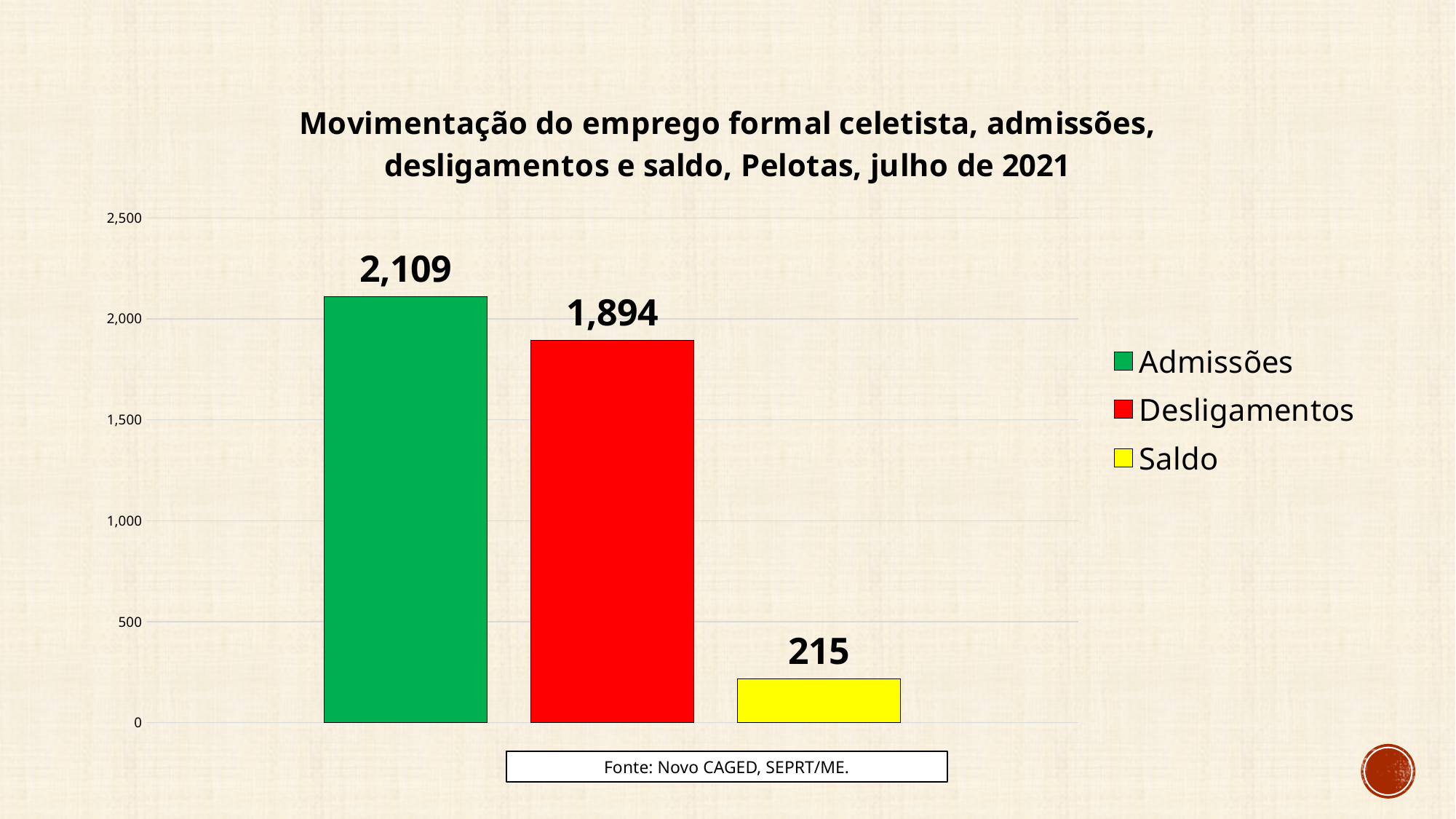
What colour is the bar for Saldo? yellow How many series does the legend list? 3 Is the value for Desligamentos greater or less than 2,000? less What is the value for Saldo? 215 What is the difference between Admissões and Desligamentos? 215 What is the value for Desligamentos? 1,894 What is the value for Admissões? 2,109 Which series has the lowest value? Saldo How many bars are plotted in the chart? 3 Which series has the highest value? Admissões Which is larger, Desligamentos or Saldo? Desligamentos What kind of chart is shown on the slide? bar chart